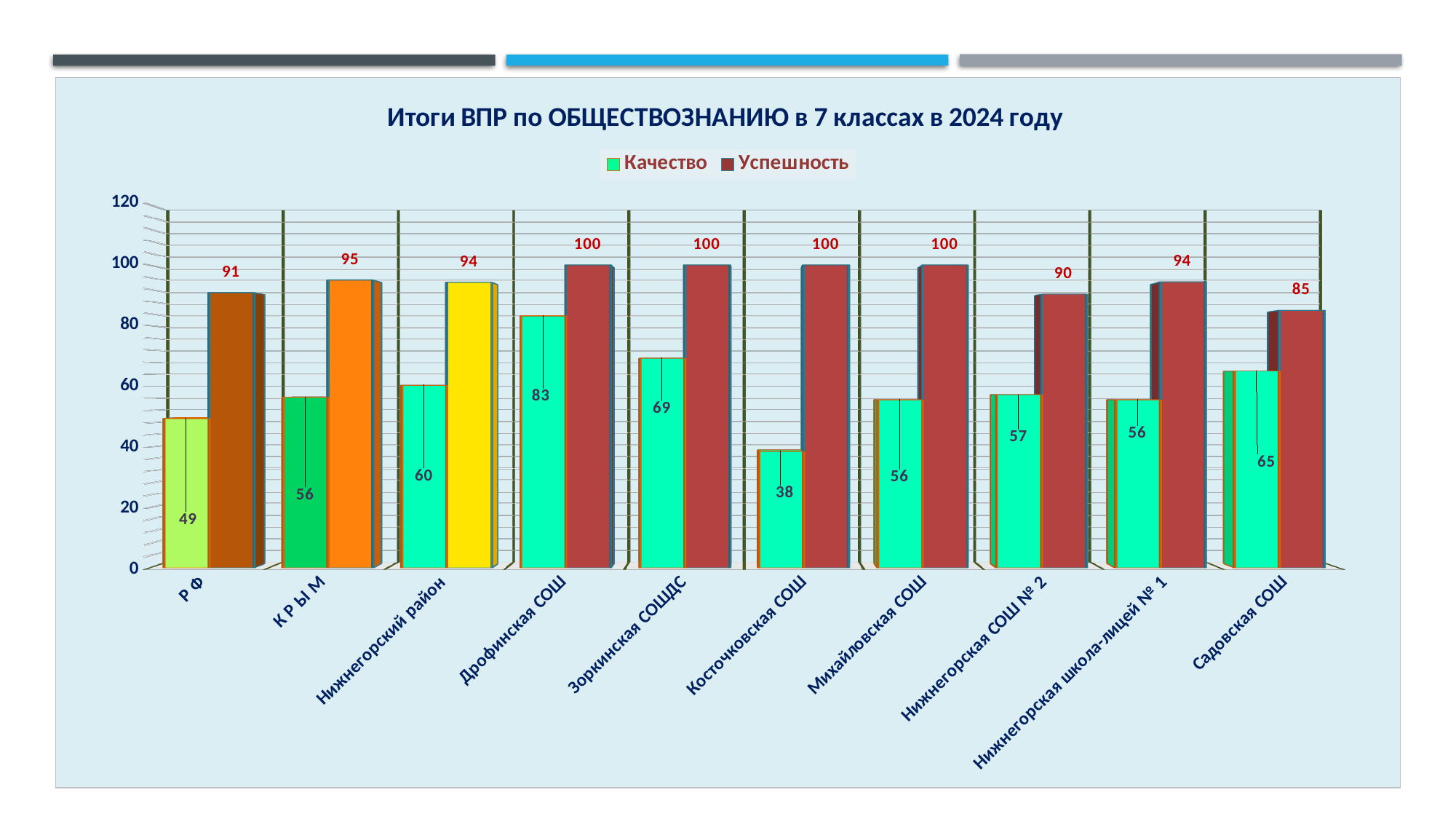
What is the difference between the Успешность and Качество values for Косточковская СОШ? 62 What is the Успешность value for Нижнегорская СОШ № 2? 90 Which is larger, the Качество value for Зоркинская СОШДС or for Садовская СОШ? Зоркинская СОШДС Which category has the lowest Качество value? Косточковская СОШ What is the Качество value for Дрофинская СОШ? 83 Which category has the lowest Успешность value? Садовская СОШ How many categories are shown on the x axis? 10 What is the Качество value for Косточковская СОШ? 38 What is the Успешность value for Садовская СОШ? 85 Which category has the highest Качество value? Дрофинская СОШ What kind of chart is shown on the slide? Bar chart How many series does the legend list? 2